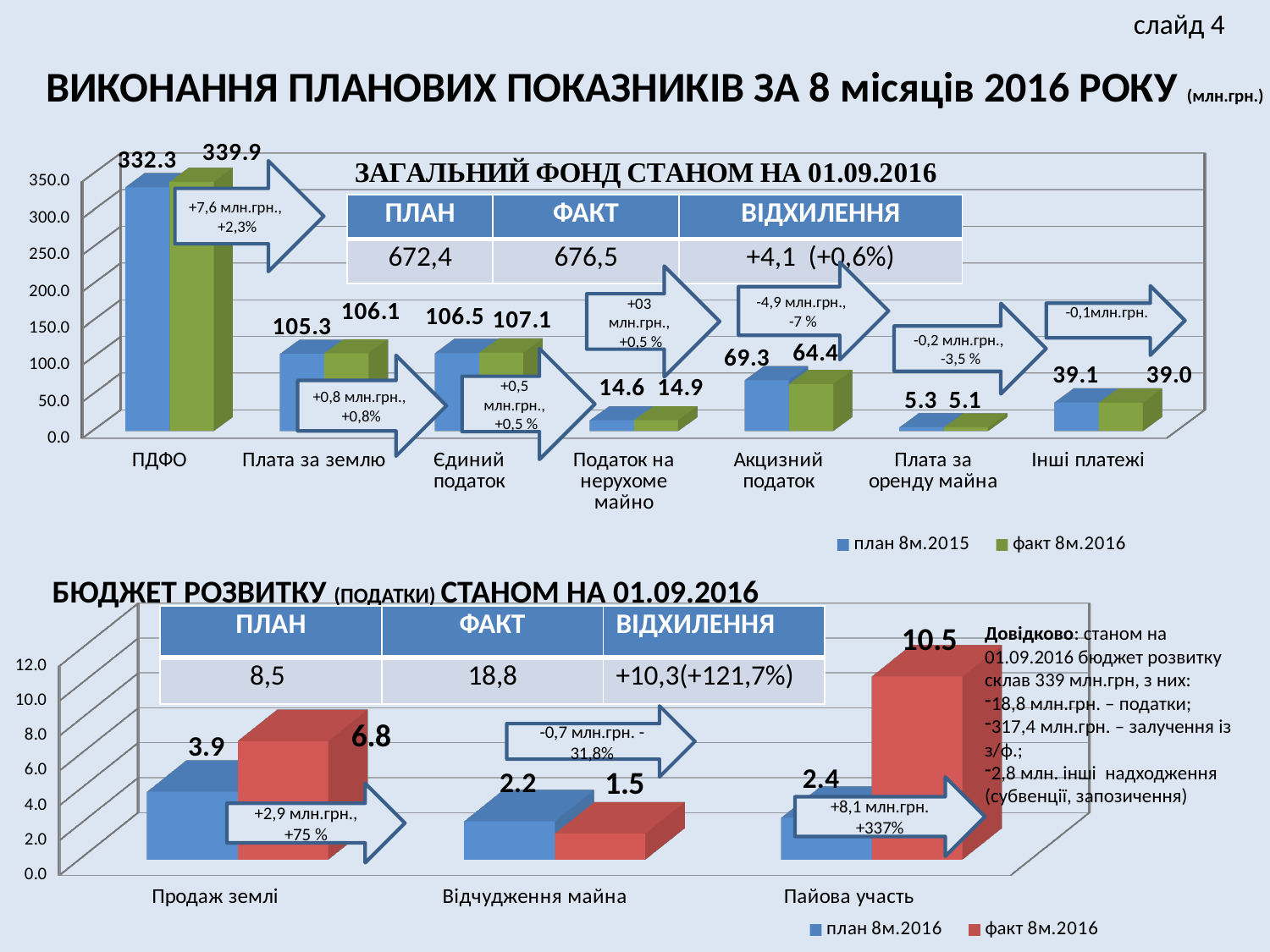
In the bottom chart (БЮДЖЕТ РОЗВИТКУ (податки) СТАНОМ НА 01.09.2016), what colour represents the факт 8м.2016 series? Red In the top chart (ЗАГАЛЬНИЙ ФОНД СТАНОМ НА 01.09.2016), what is the difference between the план 8м.2015 and факт 8м.2016 values for Акцизний податок? 4.9 In the top chart (ЗАГАЛЬНИЙ ФОНД СТАНОМ НА 01.09.2016), what is the план 8м.2015 value for Акцизний податок? 69.3 In the bottom chart (БЮДЖЕТ РОЗВИТКУ (податки) СТАНОМ НА 01.09.2016), which is larger for Відчуження майна: план 8м.2016 or факт 8м.2016? план 8м.2016 In the bottom chart (БЮДЖЕТ РОЗВИТКУ (податки) СТАНОМ НА 01.09.2016), what is the difference between the факт 8м.2016 and план 8м.2016 values for Продаж землі? 2.9 What type of chart is the bottom chart (БЮДЖЕТ РОЗВИТКУ (податки) СТАНОМ НА 01.09.2016)? Bar chart In the top chart (ЗАГАЛЬНИЙ ФОНД СТАНОМ НА 01.09.2016), how many categories are shown on the x axis? 7 In the top chart (ЗАГАЛЬНИЙ ФОНД СТАНОМ НА 01.09.2016), how many series does the legend list? 2 In the top chart (ЗАГАЛЬНИЙ ФОНД СТАНОМ НА 01.09.2016), what is the факт 8м.2016 value for ПДФО? 339.9 In the bottom chart (БЮДЖЕТ РОЗВИТКУ (податки) СТАНОМ НА 01.09.2016), what is the факт 8м.2016 value for Пайова участь? 10.5 In the top chart (ЗАГАЛЬНИЙ ФОНД СТАНОМ НА 01.09.2016), which category has the highest план 8м.2015 value? ПДФО In the top chart (ЗАГАЛЬНИЙ ФОНД СТАНОМ НА 01.09.2016), which category has the lowest факт 8м.2016 value? Плата за оренду майна